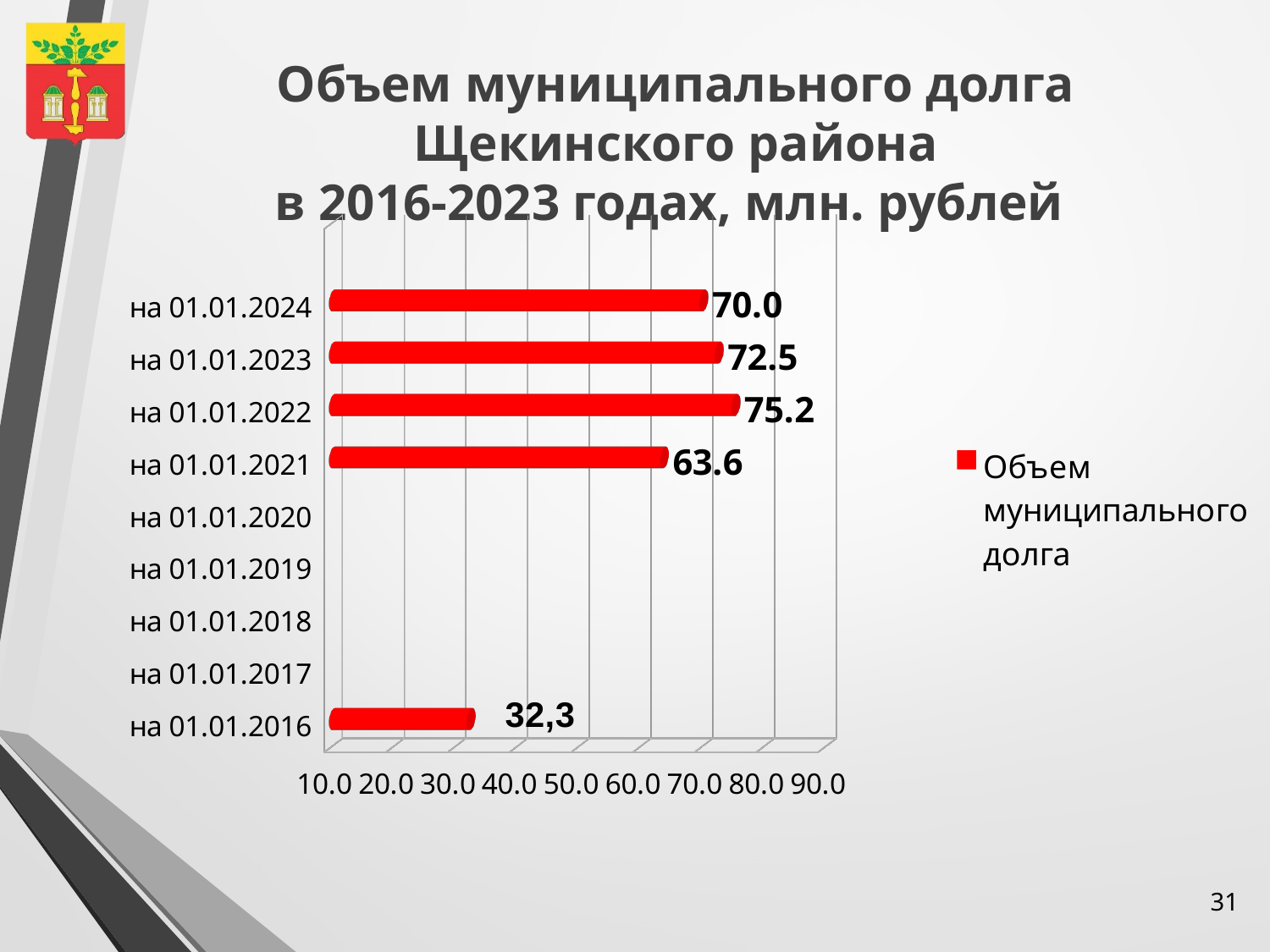
What is the difference between the values for на 01.01.2022 and на 01.01.2023? 2.7 Which is larger, the value for на 01.01.2023 or the value for на 01.01.2024? на 01.01.2023 How many categories are listed on the vertical axis? 9 What is the value for на 01.01.2021? 63.6 Among the categories with a plotted bar, which has the lowest value? на 01.01.2016 What kind of chart is shown on the slide? bar chart What is the legend entry of the chart? Объем муниципального долга Which category has the highest value? на 01.01.2022 How many series does the legend list? 1 What is the value for на 01.01.2024? 70.0 What is the value for на 01.01.2016? 32,3 What is the value for на 01.01.2022? 75.2